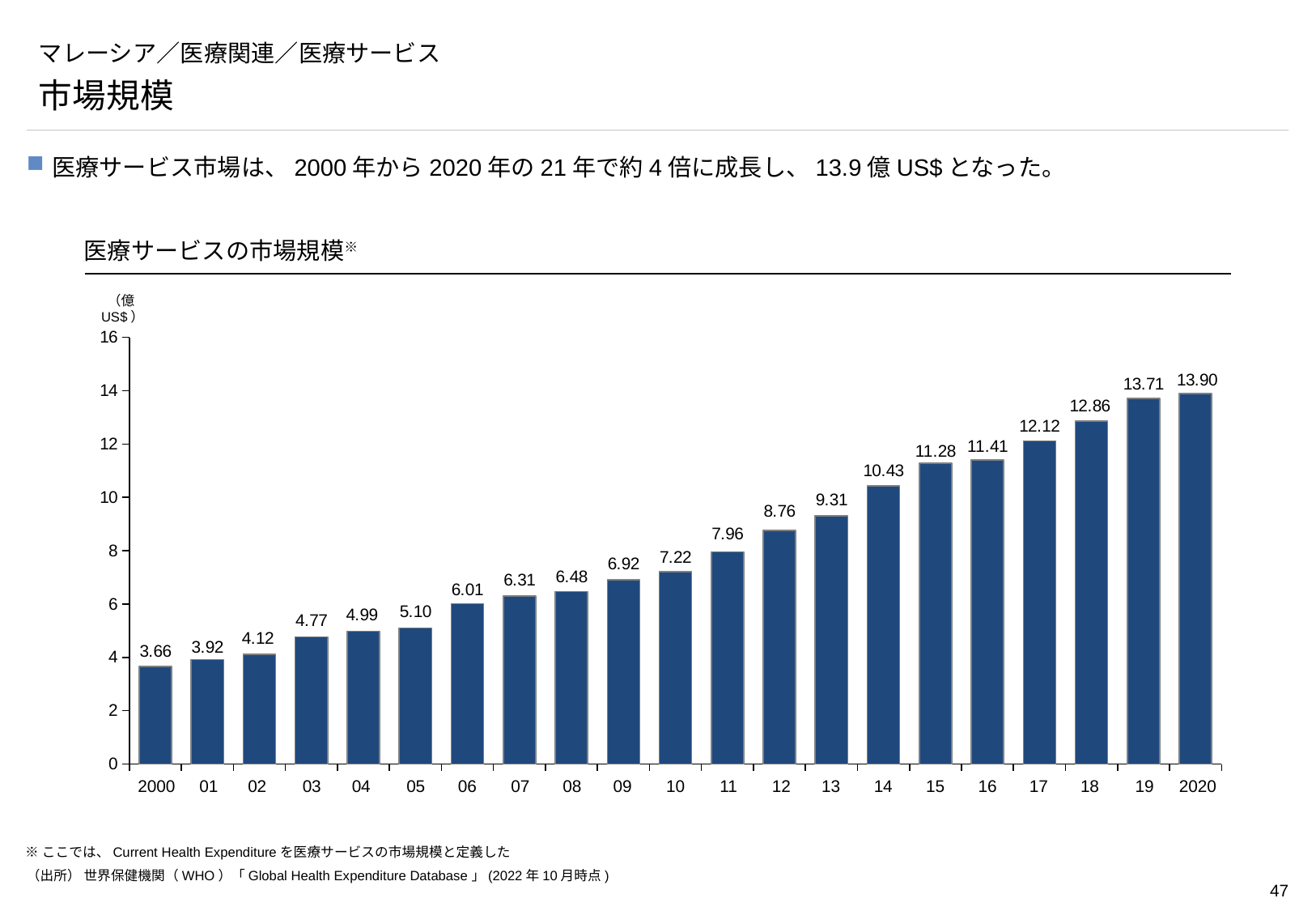
What kind of chart is shown on the slide? Bar chart What is the value shown for 2014? 10.43 Which year has the highest value in the chart? 2020 What is the market size value shown for 2000? 3.66 What unit is shown on the vertical axis of the chart? 億US$ Is the value for 2017 greater or less than 12? greater Which year has the lowest value in the chart? 2000 What is the difference between the values for 2020 and 2000? 10.24 What is the market size value shown for 2020? 13.90 Do the values rise or fall from 2000 to 2020? Rise Which is larger, the value for 2010 or the value for 2012? 2012 How many years (bars) are plotted in the chart? 21